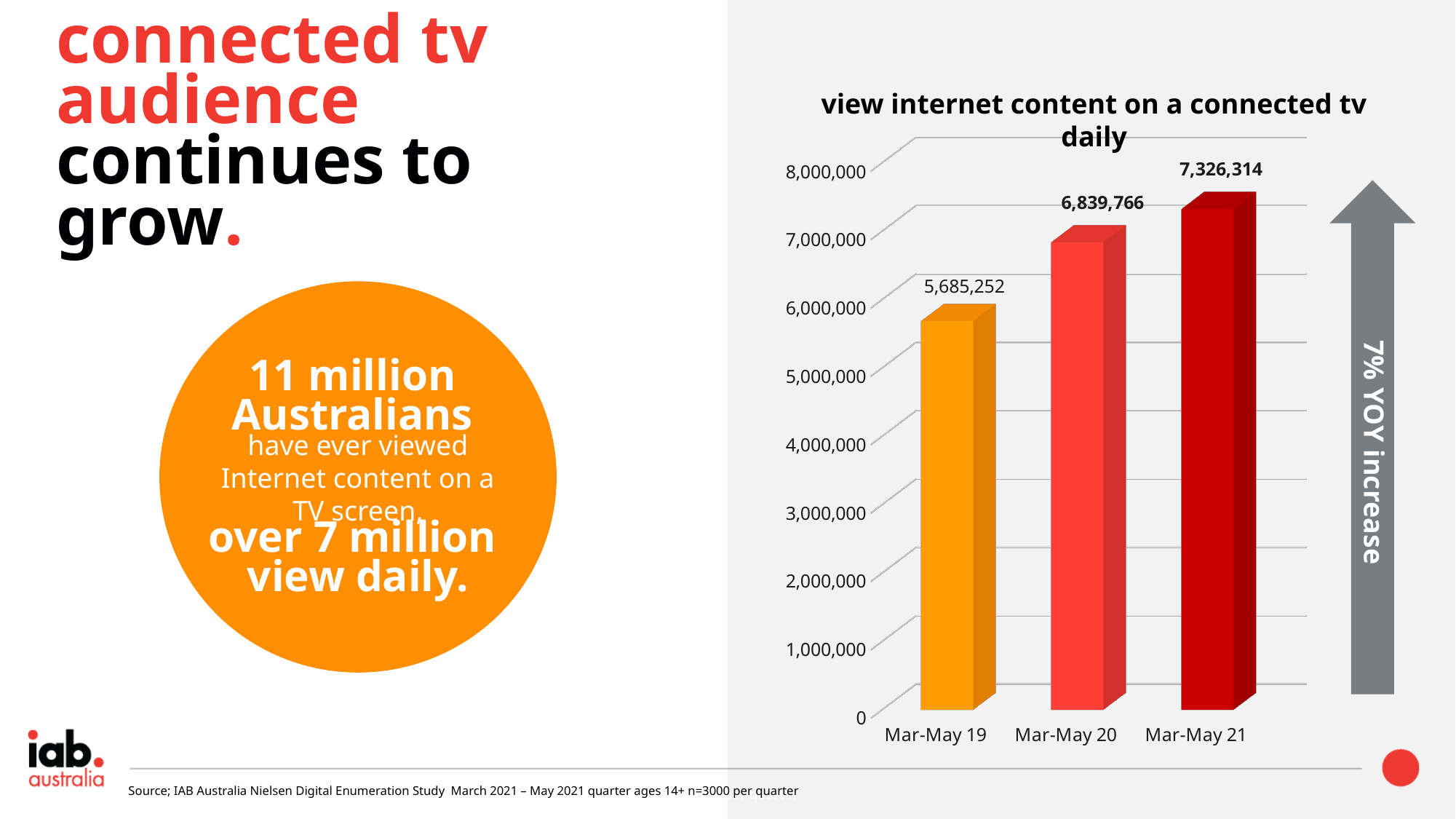
Do the values rise or fall from Mar-May 19 to Mar-May 21? rise Which is larger, the value for Mar-May 19 or Mar-May 20? Mar-May 20 What is the value for Mar-May 19? 5,685,252 What is the difference between the values for Mar-May 21 and Mar-May 20? 486,548 What is the value for Mar-May 21? 7,326,314 Which period has the highest value? Mar-May 21 What is the difference between the values for Mar-May 20 and Mar-May 19? 1,154,514 Is the value for Mar-May 21 greater or less than 7,000,000? greater Which period has the lowest value? Mar-May 19 What is the value for Mar-May 20? 6,839,766 What kind of chart is shown? bar chart How many periods are shown on the x axis? 3